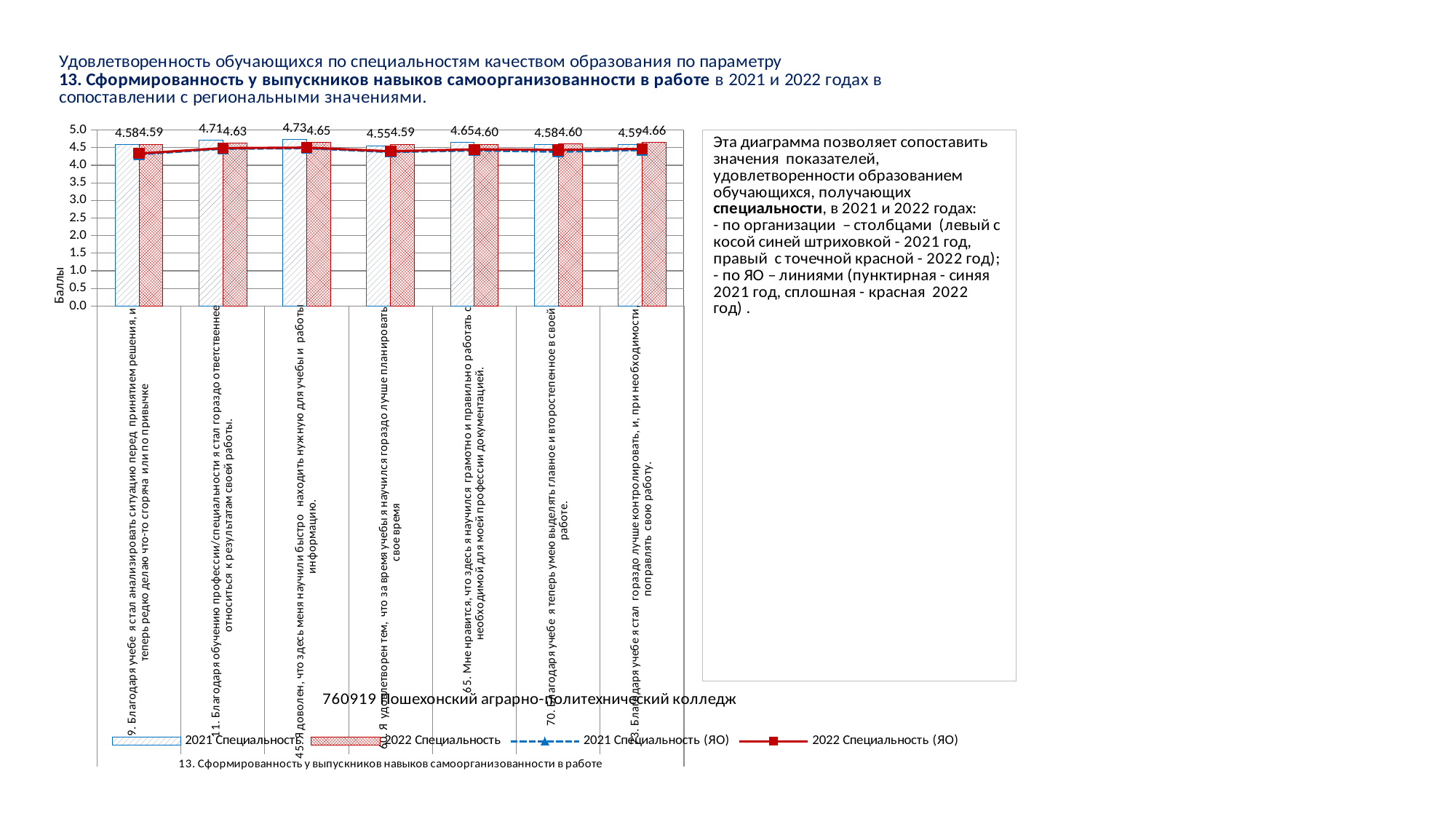
What is the 2021 Специальность value for the category "9. Благодаря учебе я стал анализировать ситуацию перед принятием решения..."? 4.58 What is the difference between the 2021 and 2022 Специальность values for the category "11. Благодаря обучению профессии/специальности я стал гораздо ответственнее..."? 0.08 What is the 2022 Специальность value for the category "70. Благодаря учебе я теперь умею выделять главное и второстепенное в своей работе"? 4.60 Which category has the lowest 2021 Специальность value? Я удовлетворен тем, что за время учебы я научился гораздо лучше планировать свое время (4.55) How many categories are shown on the x axis of the chart? 7 What is the 2022 Специальность value for the category "11. Благодаря обучению профессии/специальности я стал гораздо ответственнее..."? 4.63 Which category has the highest 2022 Специальность value? 73. Благодаря учебе я стал гораздо лучше контролировать, и, при необходимости, поправлять свою работу (4.66) What is the 2021 Специальность value for the category "45. Я доволен, что здесь меня научили быстро находить нужную для учебы и работы информацию"? 4.73 What kind of chart is shown on the slide? A combined bar and line chart Which category has the highest 2021 Специальность value? 45. Я доволен, что здесь меня научили быстро находить нужную для учебы и работы информацию (4.73) How many series does the chart legend list? 4 For the category "65. Мне нравится, что здесь я научился грамотно и правильно работать...", which is larger: the 2021 Специальность value or the 2022 Специальность value? 2021 Специальность (4.65)